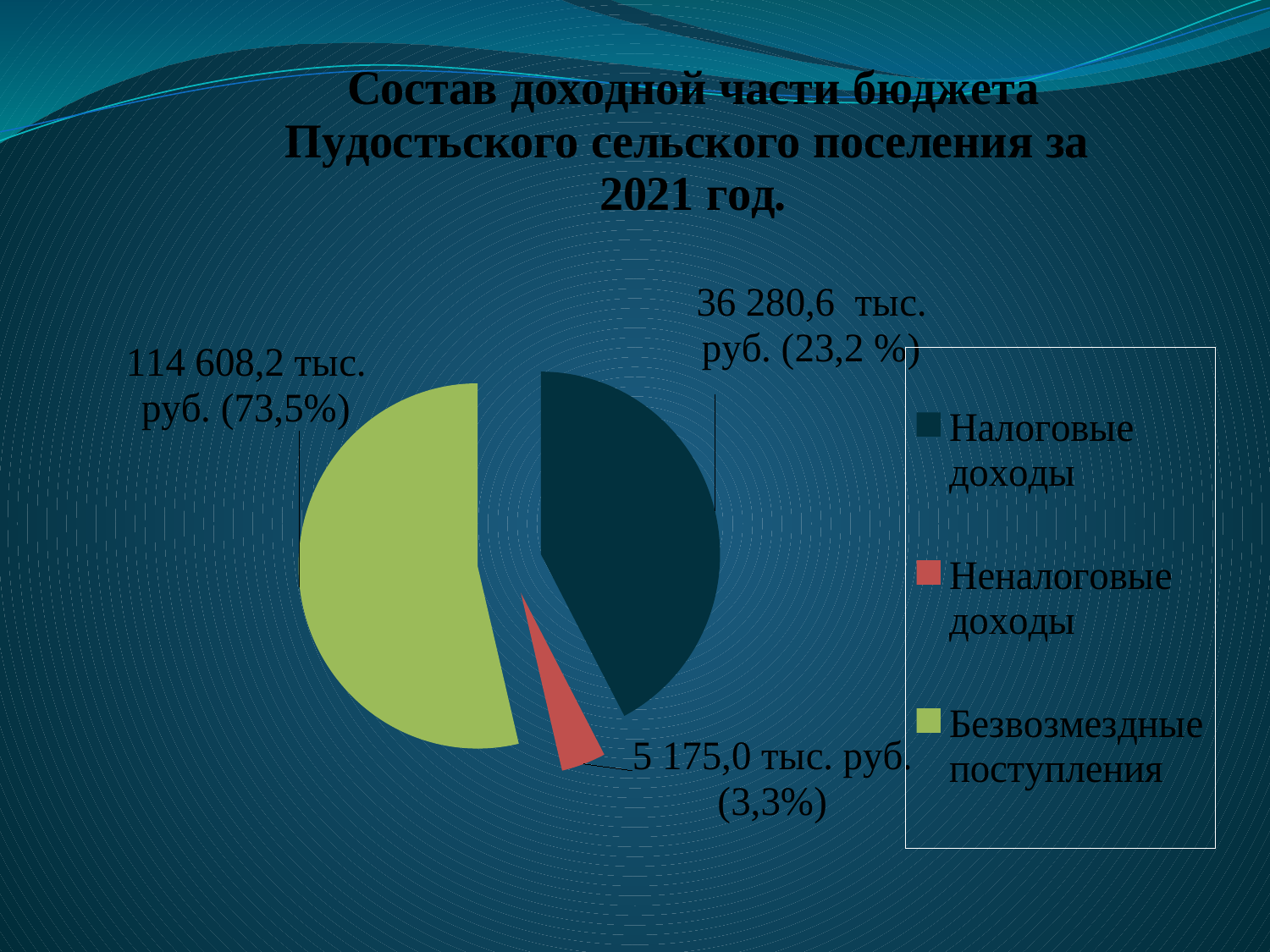
How many categories does the legend list? 3 Which category has the smallest slice of the pie? Неналоговые доходы What kind of chart is shown on the slide? Pie chart What is the difference between Безвозмездные поступления and Налоговые доходы in тыс. руб.? 78 327,6 тыс. руб. What is the value shown for Налоговые доходы? 36 280,6 тыс. руб. What share of the pie does Безвозмездные поступления represent? 73,5% What is the value shown for Неналоговые доходы? 5 175,0 тыс. руб. Which category has the largest slice of the pie? Безвозмездные поступления Which is larger, Налоговые доходы or Неналоговые доходы? Налоговые доходы What share of the pie does Налоговые доходы represent? 23,2 % What is the value shown for Безвозмездные поступления? 114 608,2 тыс. руб. What share of the pie does Неналоговые доходы represent? 3,3%